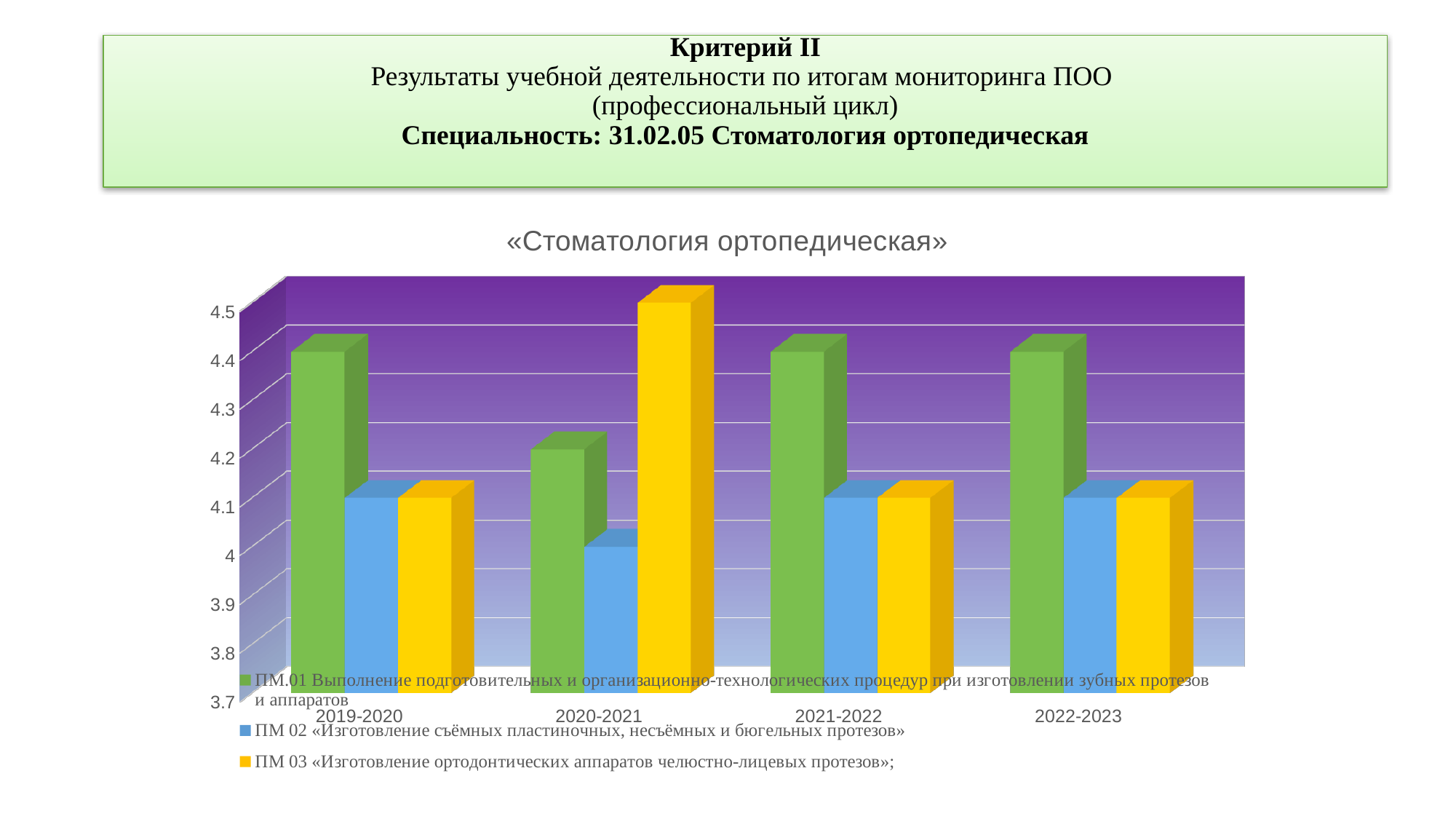
Which is larger in 2021-2022: the value for ПМ.01 or the value for ПМ 03? ПМ.01 How many academic-year categories are shown on the x axis of the chart? 4 How many series does the chart legend list? 3 Is the value for ПМ.01 in 2019-2020 greater or less than 4.3? greater In which academic year does ПМ 02 have its lowest value? 2020-2021 Which series has the lowest bar in 2019-2020 among ПМ.01 and ПМ 02? ПМ 02 What kind of chart is shown on the slide? bar chart Which series has the highest bar in 2020-2021? ПМ 03 Which series is shown in yellow in the chart? ПМ 03 «Изготовление ортодонтических аппаратов челюстно-лицевых протезов» What is the title of the chart? «Стоматология ортопедическая» Is the value for ПМ 02 in 2020-2021 greater or less than 4.1? less In which academic year does ПМ 03 reach its highest value? 2020-2021